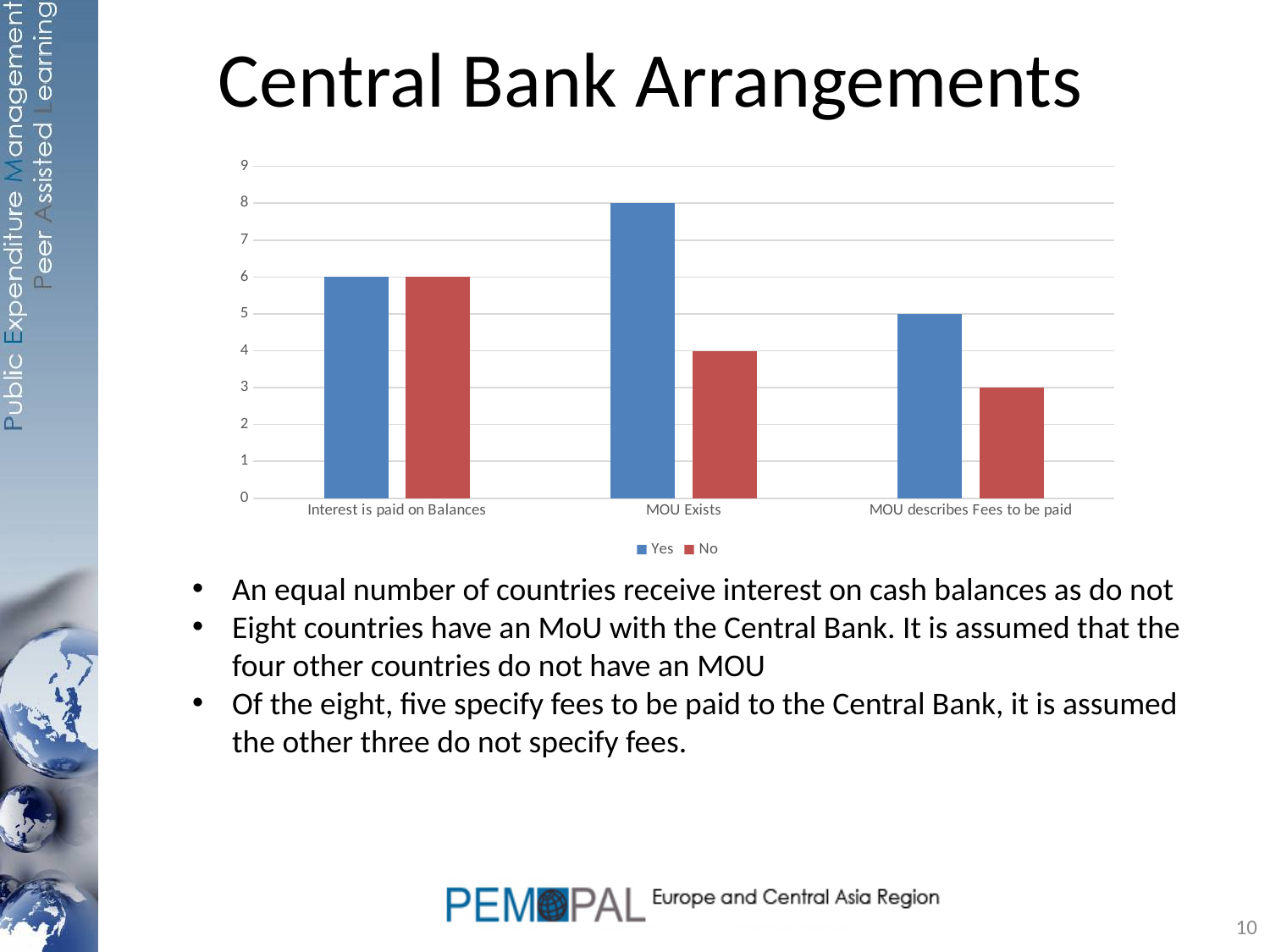
What is the value of the No bar for MOU describes Fees to be paid? 3 Is the Yes value for MOU Exists greater or less than 7? greater Which is larger for MOU describes Fees to be paid, the Yes value or the No value? Yes What is the value of the Yes bar for Interest is paid on Balances? 6 What colour are the No bars? red What is the difference between the Yes and No values for MOU Exists? 4 What kind of chart is shown on the slide? bar chart How many series does the legend list? 2 What is the value of the Yes bar for MOU Exists? 8 How many categories are shown on the x axis? 3 Which category has the highest Yes value? MOU Exists Which category has the lowest No value? MOU describes Fees to be paid